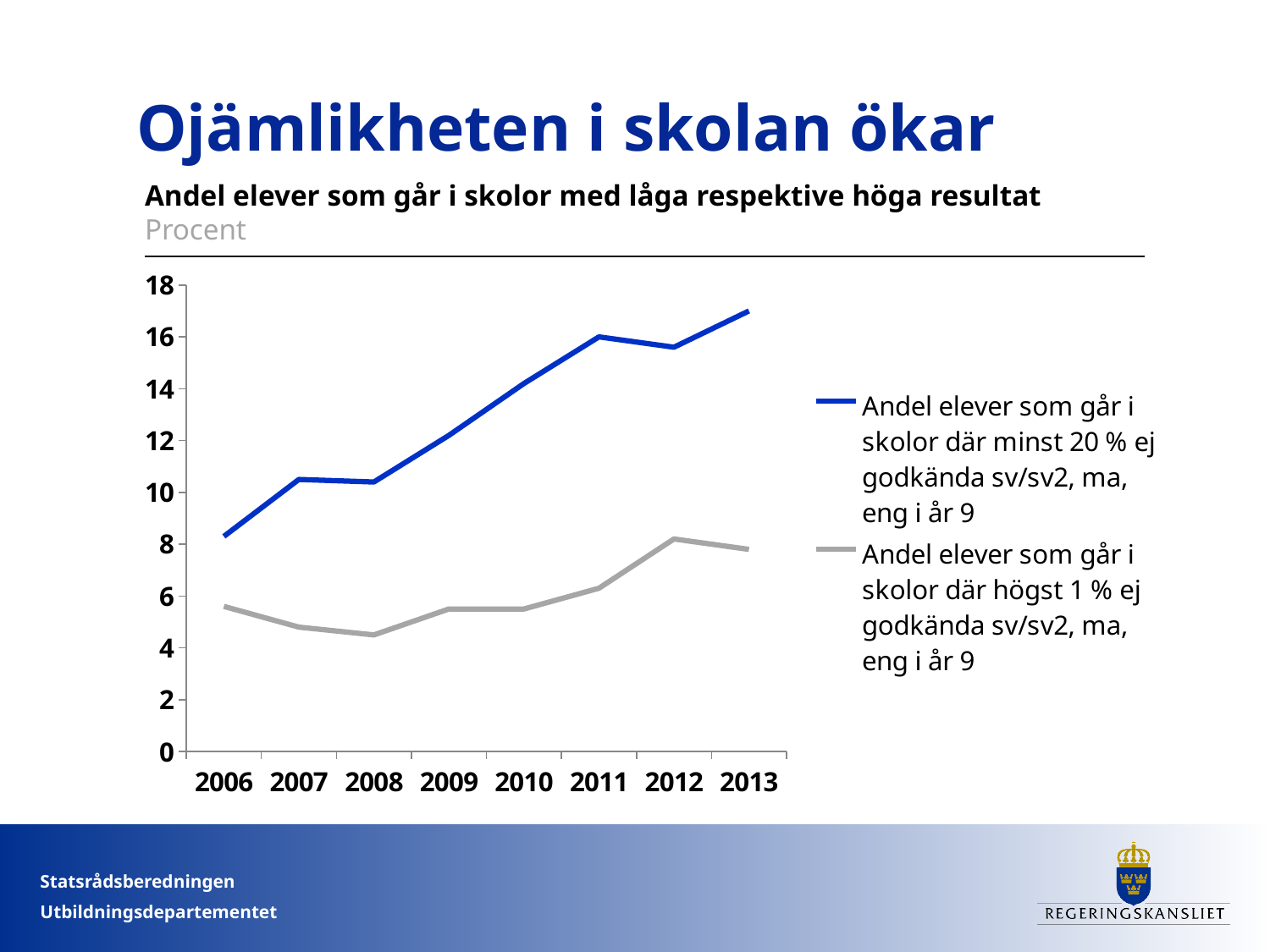
In which year is the share of pupils in schools where at least 20 % are not passing (blue line) highest? 2013 In which year is the share of pupils in schools where at most 1 % are not passing (grey line) highest? 2012 How many series does the legend list? 2 How many years are shown on the x axis? 8 Is the value of the blue line in 2013 greater or less than 16? greater What kind of chart is shown on the slide? line chart In 2013, which series has the larger value: the blue line or the grey line? the blue line Is the value of the blue line in 2006 greater or less than 10? less Is the value of the grey line in 2008 greater or less than 6? less Does the blue line generally rise or fall from 2006 to 2013? rise In which year is the share of pupils in schools where at least 20 % are not passing (blue line) lowest? 2006